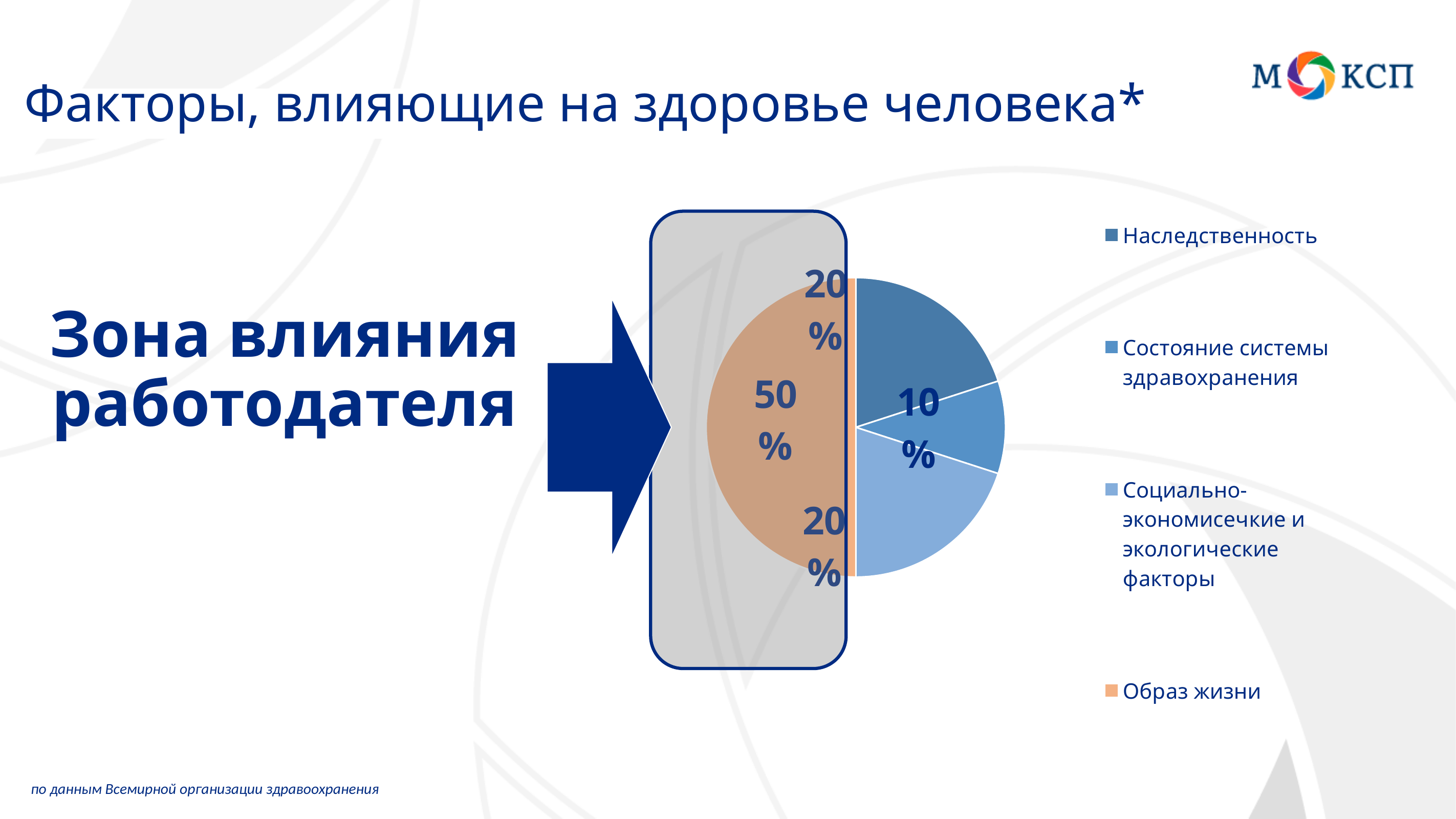
What is the difference between the values for Образ жизни and Наследственность? 30% What is the value for Наследственность? 20% Which factor has the largest slice of the pie? Образ жизни What kind of chart is shown on the slide? pie chart What is the value for Социально-экономисечкие и экологические факторы? 20% How many entries does the legend list? 4 Which is larger, the value for Наследственность or the value for Состояние системы здравоохранения? Наследственность What is the title of the slide containing the chart? Факторы, влияющие на здоровье человека* How many slices does the pie chart have? 4 What share of the pie does Образ жизни account for? 50% What is the value for Состояние системы здравоохранения? 10% Which factor has the smallest slice of the pie? Состояние системы здравоохранения